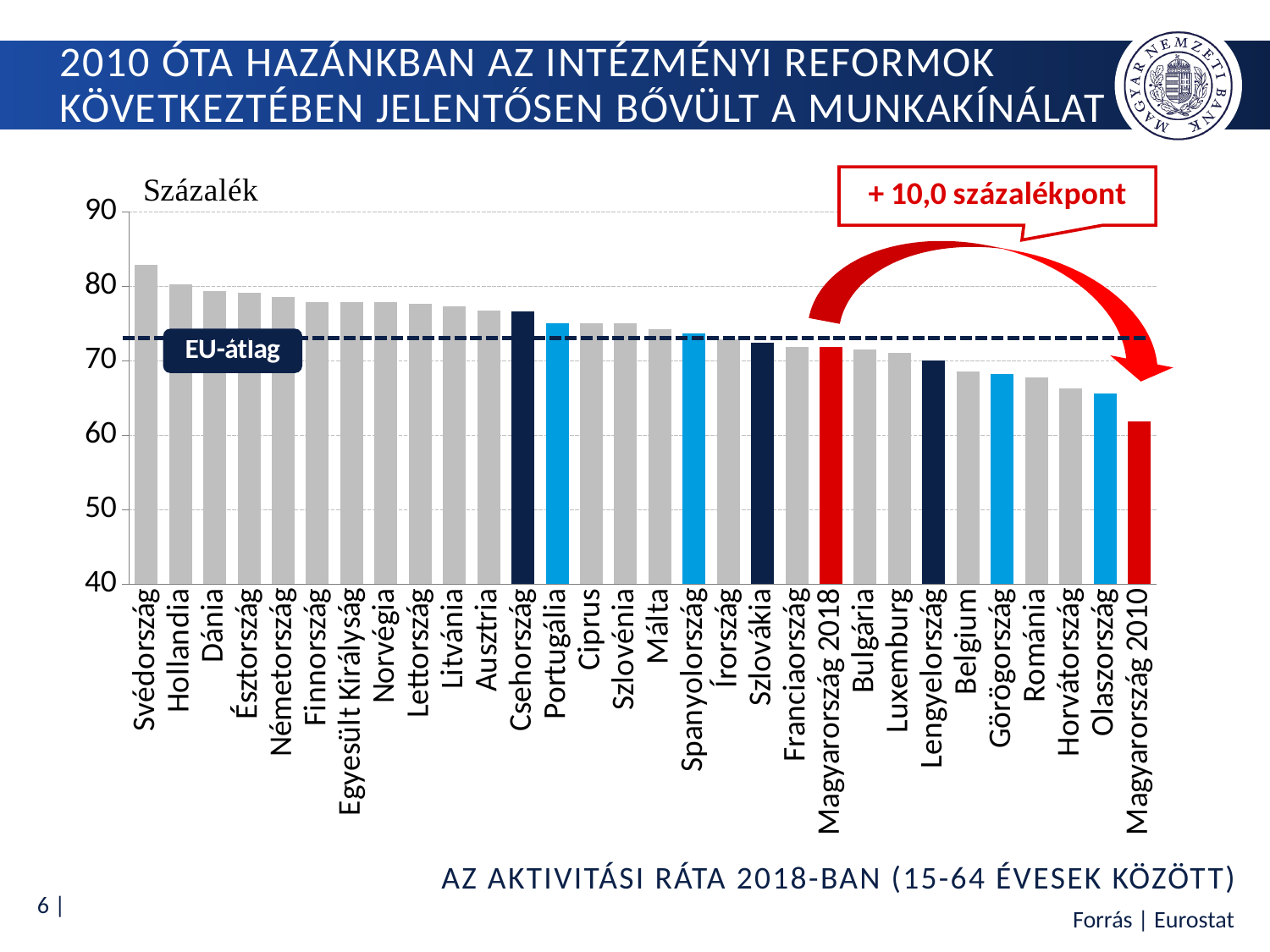
Is the value for Magyarország 2010 greater or less than 60? greater How many bars are plotted in the chart? 30 Which is larger, the value for Svédország or the value for Olaszország? Svédország Is the value for Svédország greater or less than 80? greater Do the bar values rise or fall from left to right along the x axis? fall Which bar is the lowest in the chart? Magyarország 2010 Is the value for Csehország greater or less than 70? greater Which country has the highest activity rate in the chart? Svédország According to the annotation, by how much did Hungary's activity rate change between 2010 and 2018? + 10,0 százalékpont What does the dashed horizontal line in the chart represent? EU-átlag What kind of chart is shown on the slide? bar chart